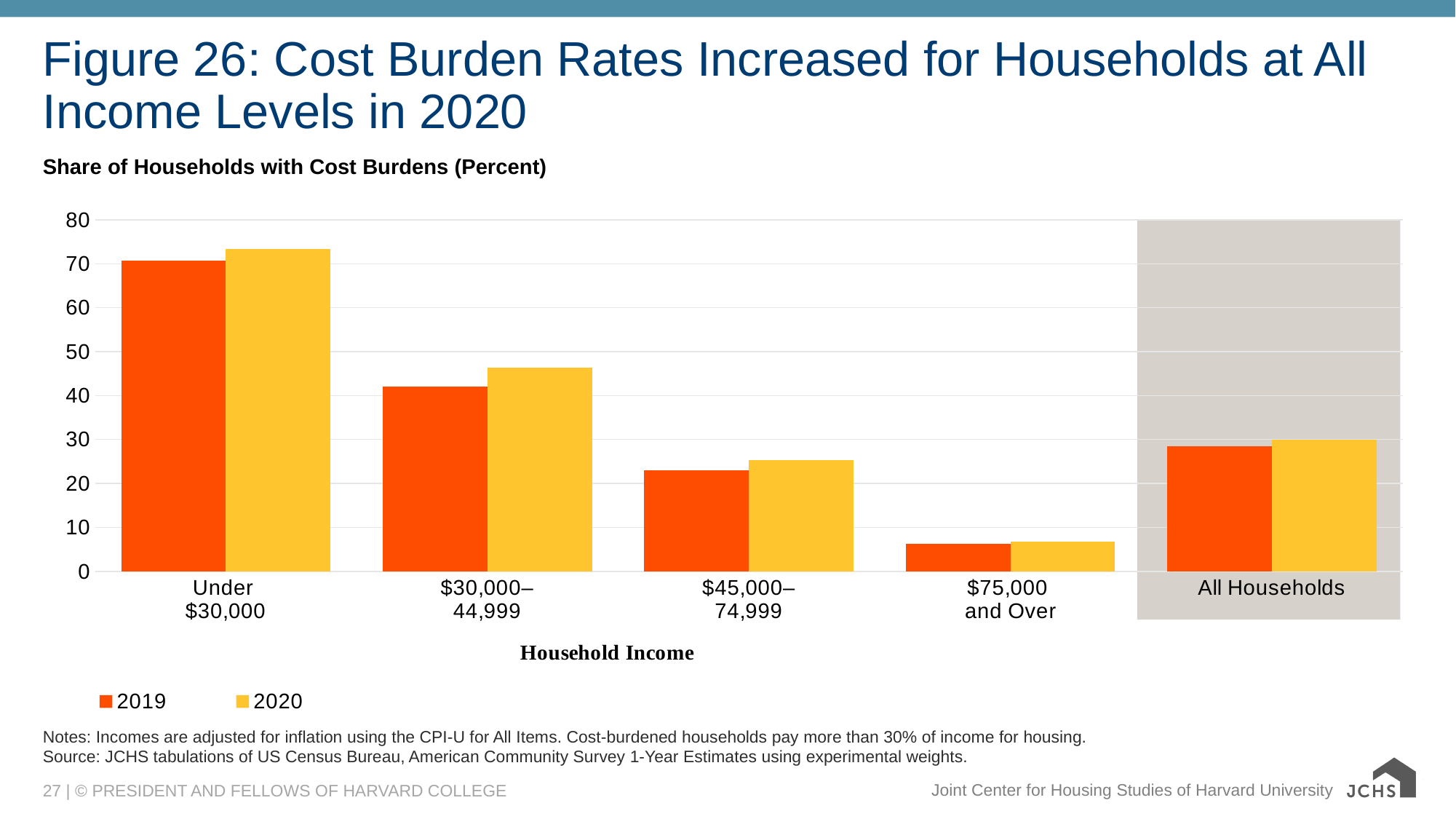
Is the 2020 value for $30,000–44,999 greater or less than 50? less How many household income categories are shown on the x axis? 5 How many series does the legend list? 2 Is the 2020 value for $75,000 and Over greater or less than 10? less Moving from Under $30,000 to $75,000 and Over, do the 2019 values rise or fall? fall Which household income category has the lowest cost burden rate in 2019? $75,000 and Over What kind of chart is shown on the slide? bar chart For the $30,000–44,999 category, which year has the larger value, 2019 or 2020? 2020 Which household income category has the highest cost burden rate in 2020? Under $30,000 Which colour represents the 2019 series in the legend? orange Is the 2019 value for $45,000–74,999 greater or less than 20? greater